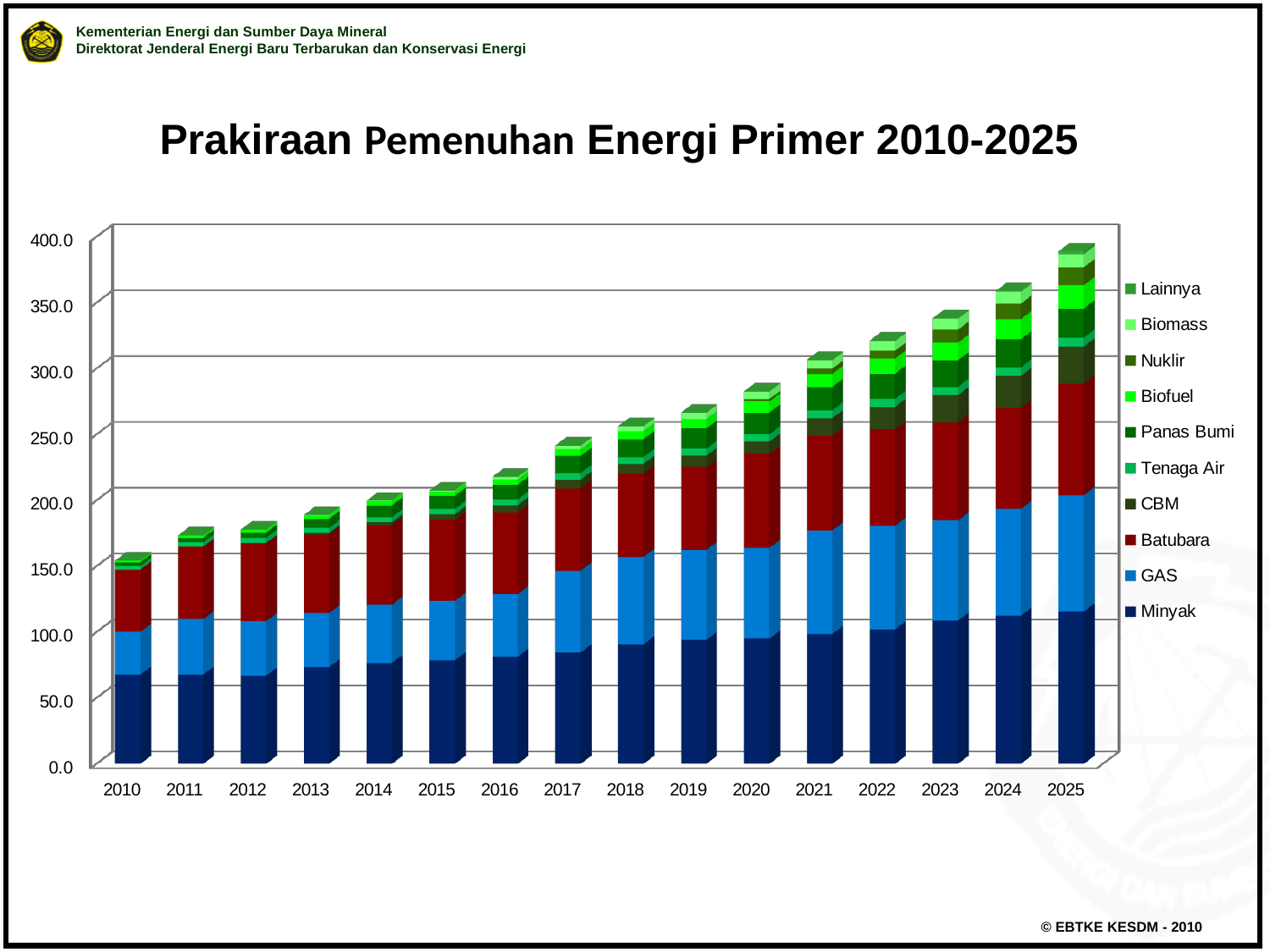
What kind of chart is shown on the slide? Stacked bar chart Is the total bar for 2020 greater or less than 250? greater How many series does the legend list? 10 Is the Minyak segment for 2025 greater or less than 100? greater Which year has the lowest total stacked bar? 2010 What is the title of the chart? Prakiraan Pemenuhan Energi Primer 2010-2025 Is the total bar for 2010 greater or less than 200? less Do the total bar heights rise or fall from 2010 to 2025? Rise Which series is shown at the bottom of each stacked bar? Minyak How many years are shown along the x axis? 16 Which year has the highest total stacked bar? 2025